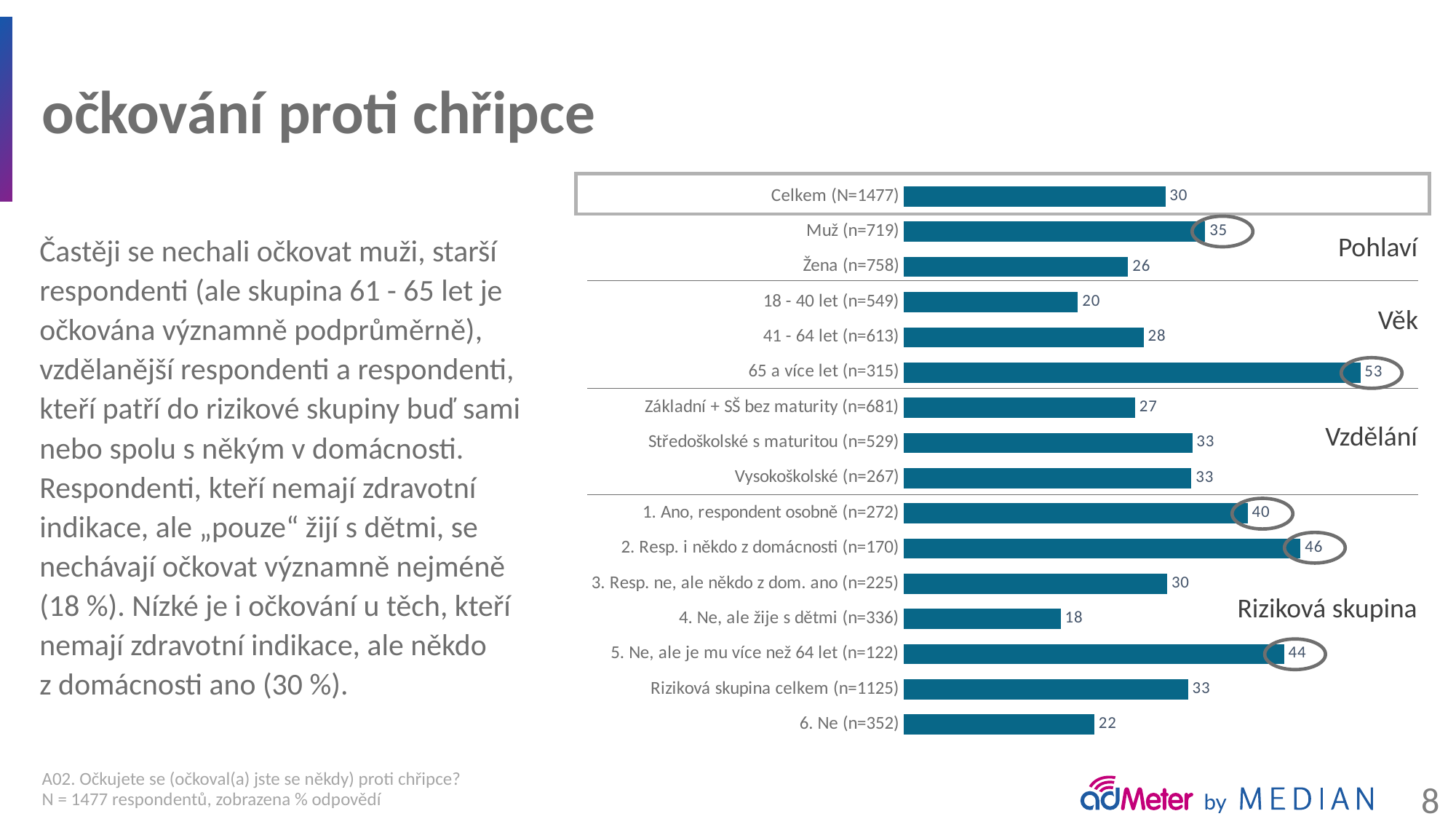
What is the value for 65 a více let (n=315)? 53 What is the value for Riziková skupina celkem (n=1125)? 33 What is the value for 4. Ne, ale žije s dětmi (n=336)? 18 What kind of chart is shown on the slide? bar chart Which category has the highest value in the chart? 65 a více let (n=315) How many bars are shown in the chart? 16 What is the value for Celkem (N=1477)? 30 Which is larger, the value for 2. Resp. i někdo z domácnosti (n=170) or the value for 1. Ano, respondent osobně (n=272)? 2. Resp. i někdo z domácnosti (n=170) Which category has the lowest value in the chart? 4. Ne, ale žije s dětmi (n=336) What is the value for Muž (n=719)? 35 What is the difference between the values for Muž (n=719) and Žena (n=758)? 9 What is the difference between the values for 65 a více let (n=315) and 18 - 40 let (n=549)? 33